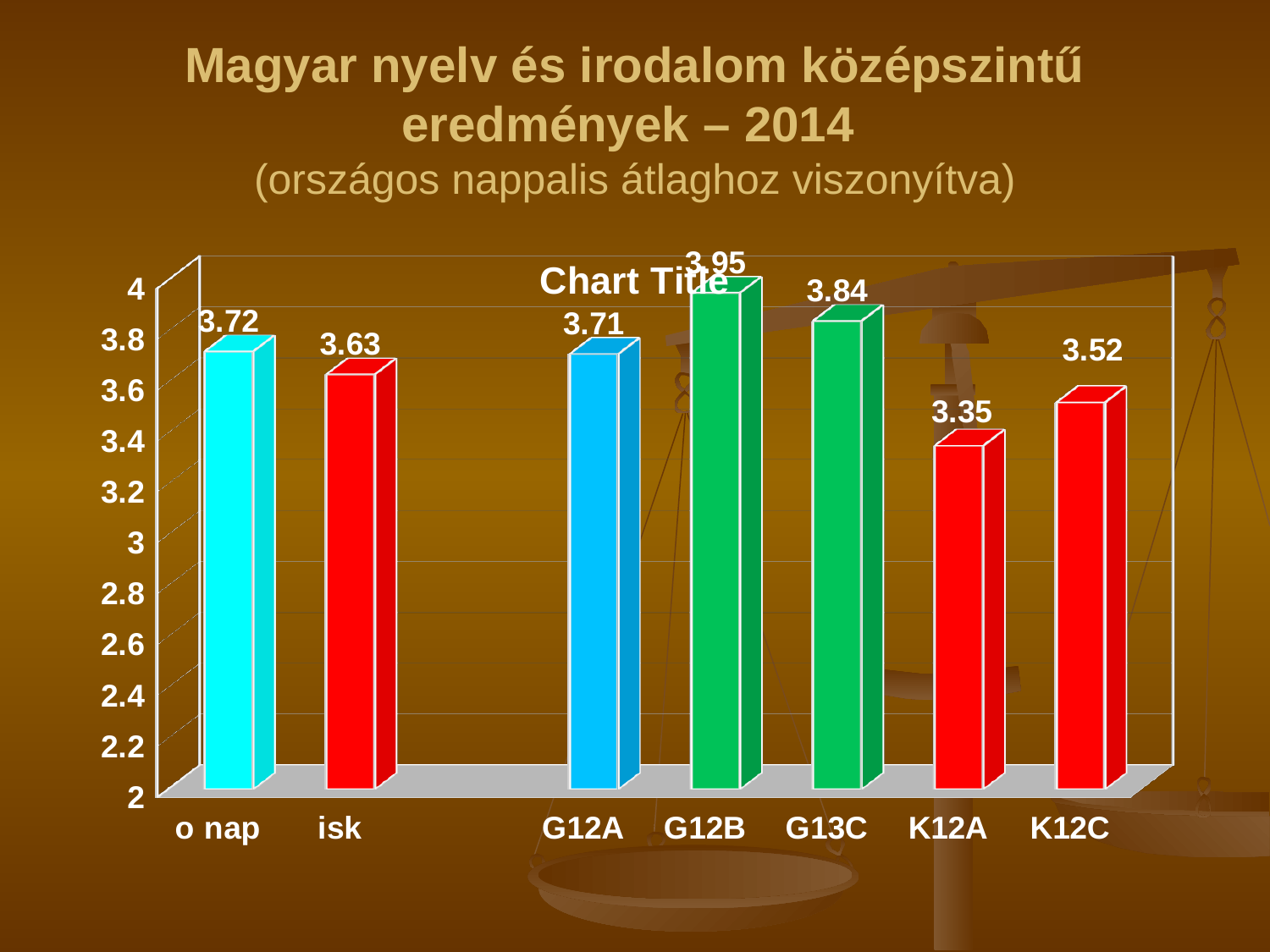
How many labelled categories are shown on the x axis? 7 What kind of chart is shown on the slide? bar chart Which category has the highest value? G12B What is the value for K12A? 3.35 What is the difference between the values for G12B and K12A? 0.6 Which is larger, the value for G13C or the value for isk? G13C Which category has the lowest value? K12A What is the value for o nap? 3.72 What is the value for isk? 3.63 What is the difference between the values for G13C and K12C? 0.32 Is the value for K12C greater or less than 3.6? less What is the value for G12B? 3.95